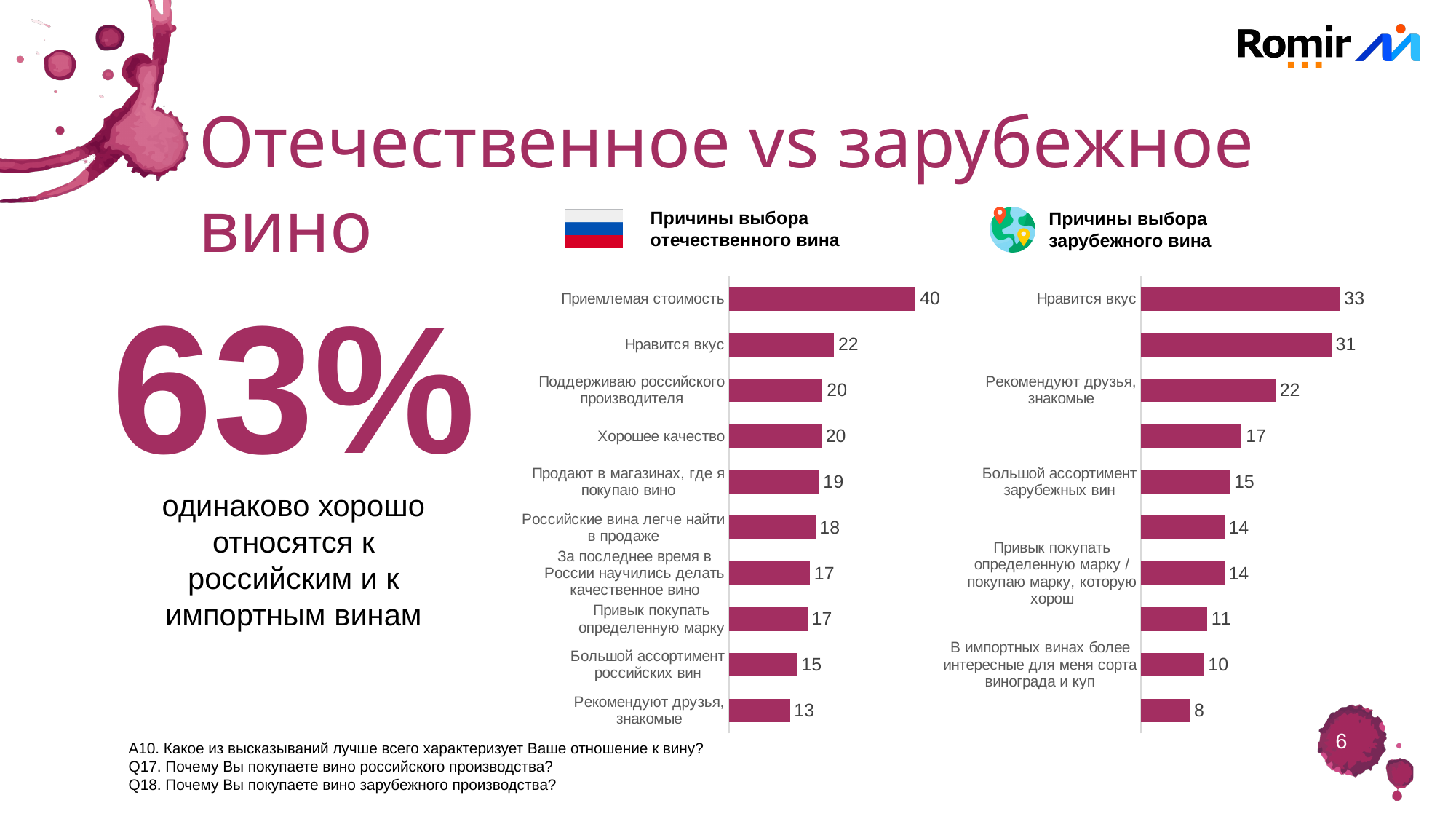
Which is larger: 'Нравится вкус' in the chart 'Причины выбора отечественного вина' or 'Нравится вкус' in the chart 'Причины выбора зарубежного вина'? Причины выбора зарубежного вина In the chart 'Причины выбора зарубежного вина', which category has the highest value? Нравится вкус In the chart 'Причины выбора зарубежного вина', what is the value for 'Рекомендуют друзья, знакомые'? 22 In the chart 'Причины выбора отечественного вина', what is the value for 'Приемлемая стоимость'? 40 In the chart 'Причины выбора отечественного вина', which category has the lowest value? Рекомендуют друзья, знакомые What type of chart is 'Причины выбора зарубежного вина'? Bar chart In the chart 'Причины выбора отечественного вина', what is the difference between 'Приемлемая стоимость' and 'Нравится вкус'? 18 In the chart 'Причины выбора отечественного вина', which category has the highest value? Приемлемая стоимость How many bars are shown in the chart 'Причины выбора отечественного вина'? 10 In the chart 'Причины выбора зарубежного вина', what is the value for 'Большой ассортимент зарубежных вин'? 15 In the chart 'Причины выбора отечественного вина', what is the value for 'Нравится вкус'? 22 In the chart 'Причины выбора отечественного вина', what is the value for 'Большой ассортимент российских вин'? 15